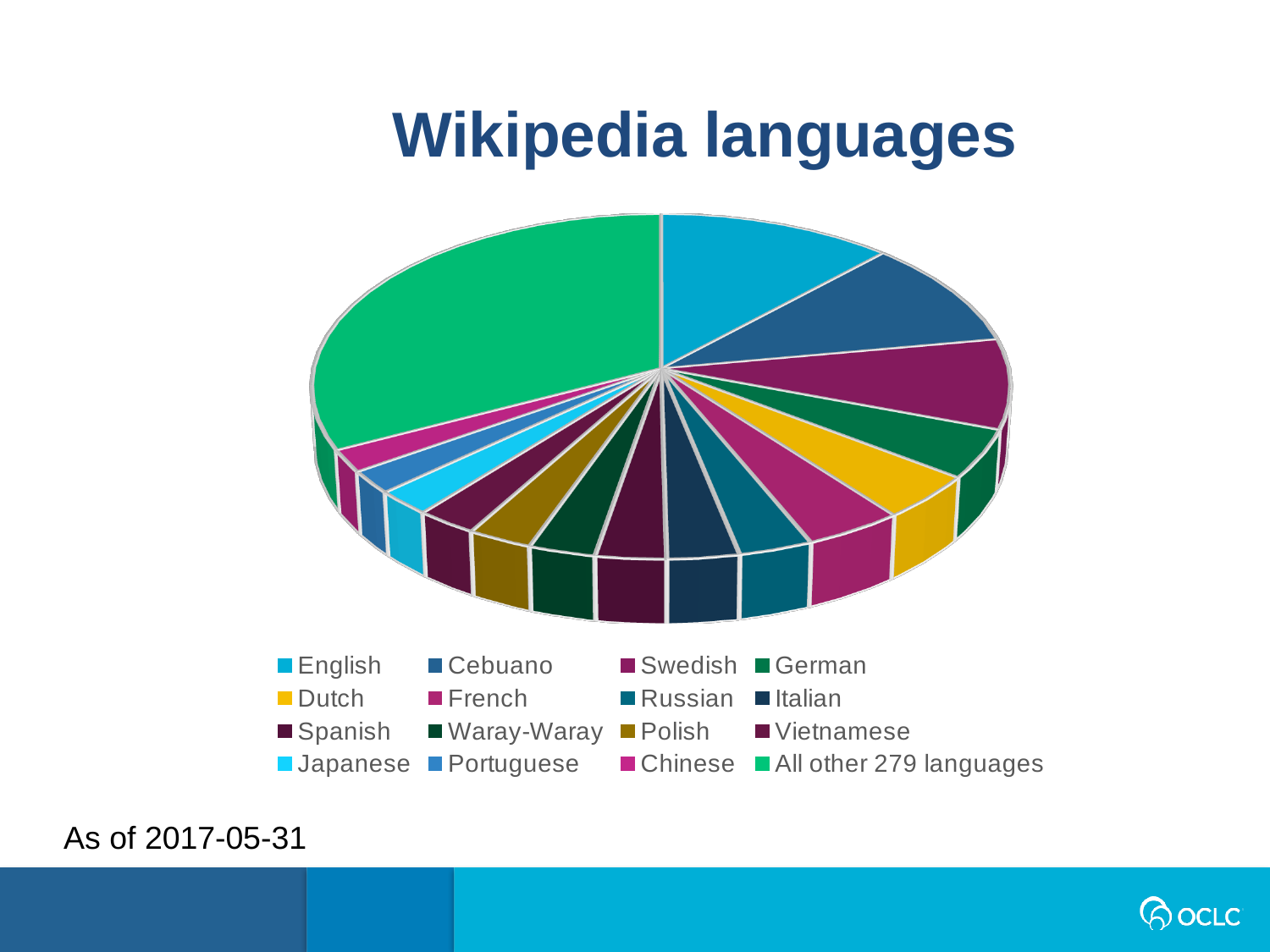
Which slice is larger, English or Japanese? English Which slice is larger, Cebuano or Portuguese? Cebuano Which is the last category listed in the legend? All other 279 languages Which slice is larger, Swedish or Chinese? Swedish What is the title of the chart? Wikipedia languages What kind of chart is shown on the slide? pie chart As of what date is the chart data, according to the note on the slide? 2017-05-31 Which category has the largest slice of the pie? All other 279 languages How many categories does the legend of the pie chart list? 16